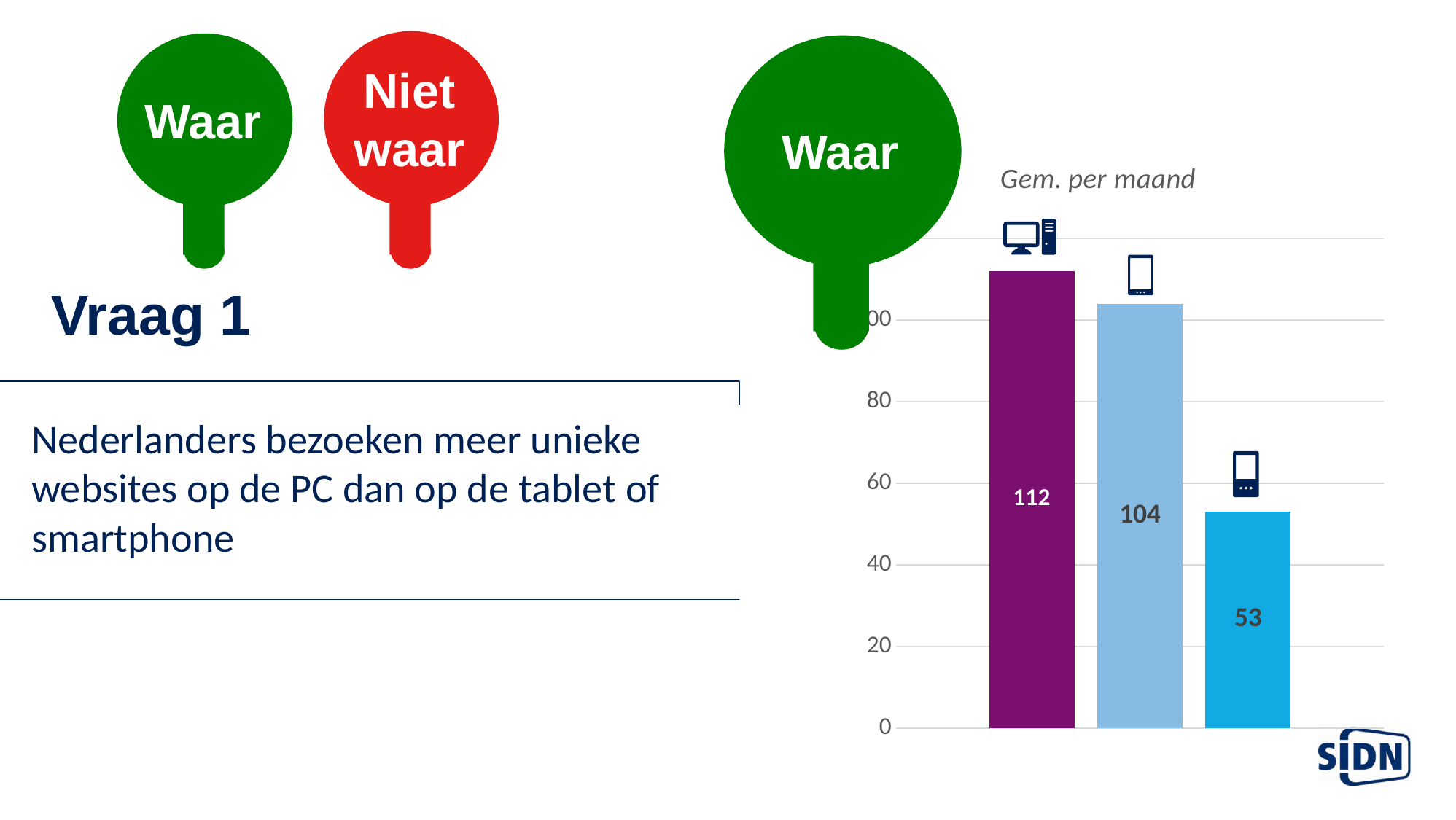
How many bars are plotted in the chart? 3 What value is shown on the first (purple) bar, marked with the desktop computer icon? 112 What value is shown on the rightmost bar, marked with the smartphone icon? 53 Which bar has the highest value? The first (purple) bar with the desktop computer icon, 112 Which bar has the lowest value? The rightmost bar with the smartphone icon, 53 Is the value of the smartphone bar greater or less than 60? less What value is shown on the middle (light blue) bar, marked with the tablet icon? 104 What is the title text shown above the chart? Gem. per maand Which is larger: the value of the tablet bar or the smartphone bar? The tablet bar (104) What kind of chart is shown on the slide? Bar chart What is the difference between the value of the desktop computer bar and the tablet bar? 8 What is the difference between the value of the desktop computer bar and the smartphone bar? 59